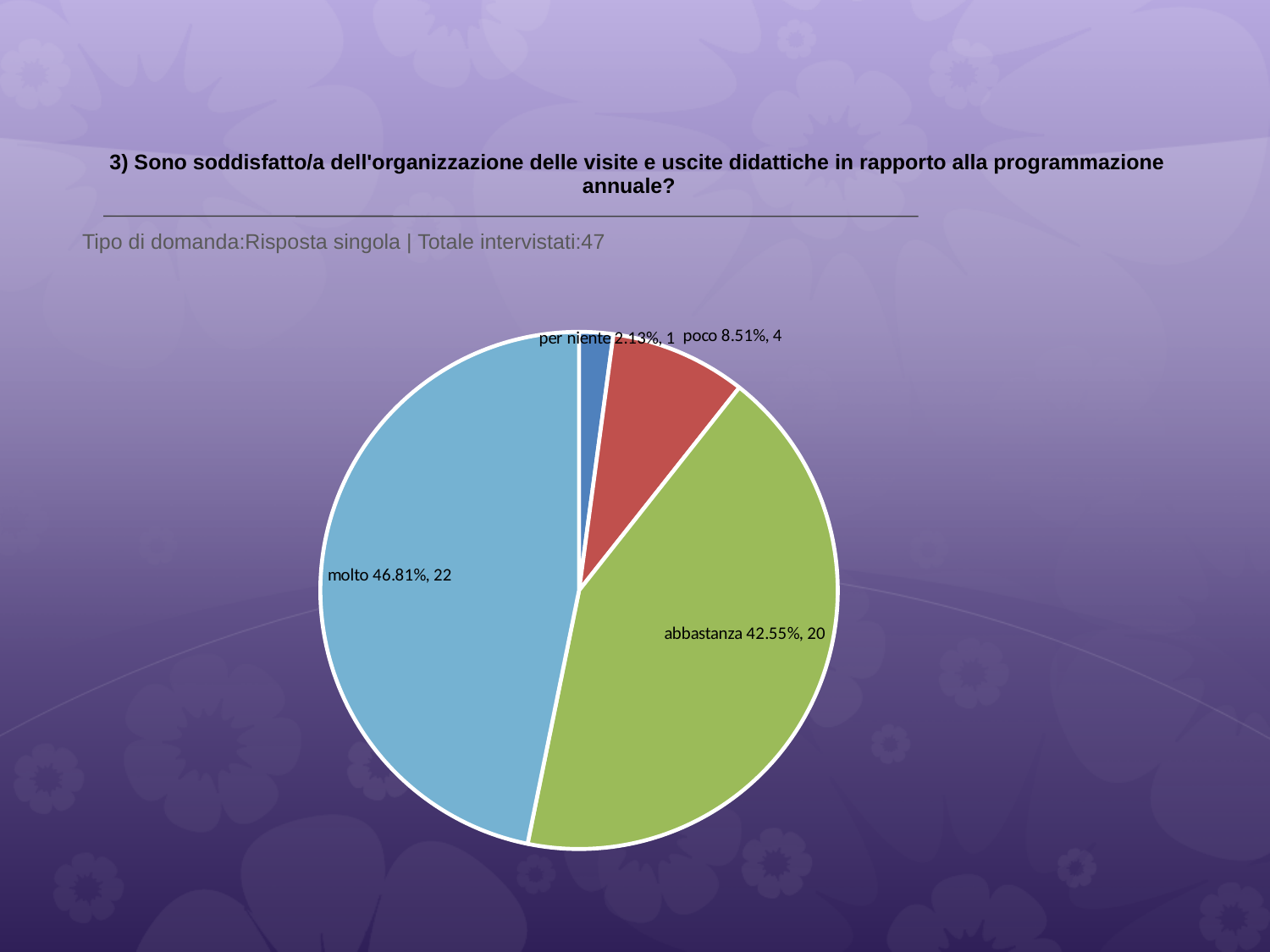
What kind of chart is shown on the slide? pie chart How many slices does the pie chart have? 4 What colour is the 'abbastanza' slice? green What percentage share does the 'poco' slice have? 8.51% Which category has the smallest slice? per niente Which category has the largest slice? molto What is the difference in respondent count between 'molto' and 'abbastanza'? 2 What is the total number of respondents stated on the slide? 47 What percentage share does the 'molto' slice have? 46.81% How many respondents answered 'abbastanza'? 20 How many respondents answered 'per niente'? 1 Which has more respondents, 'poco' or 'per niente'? poco